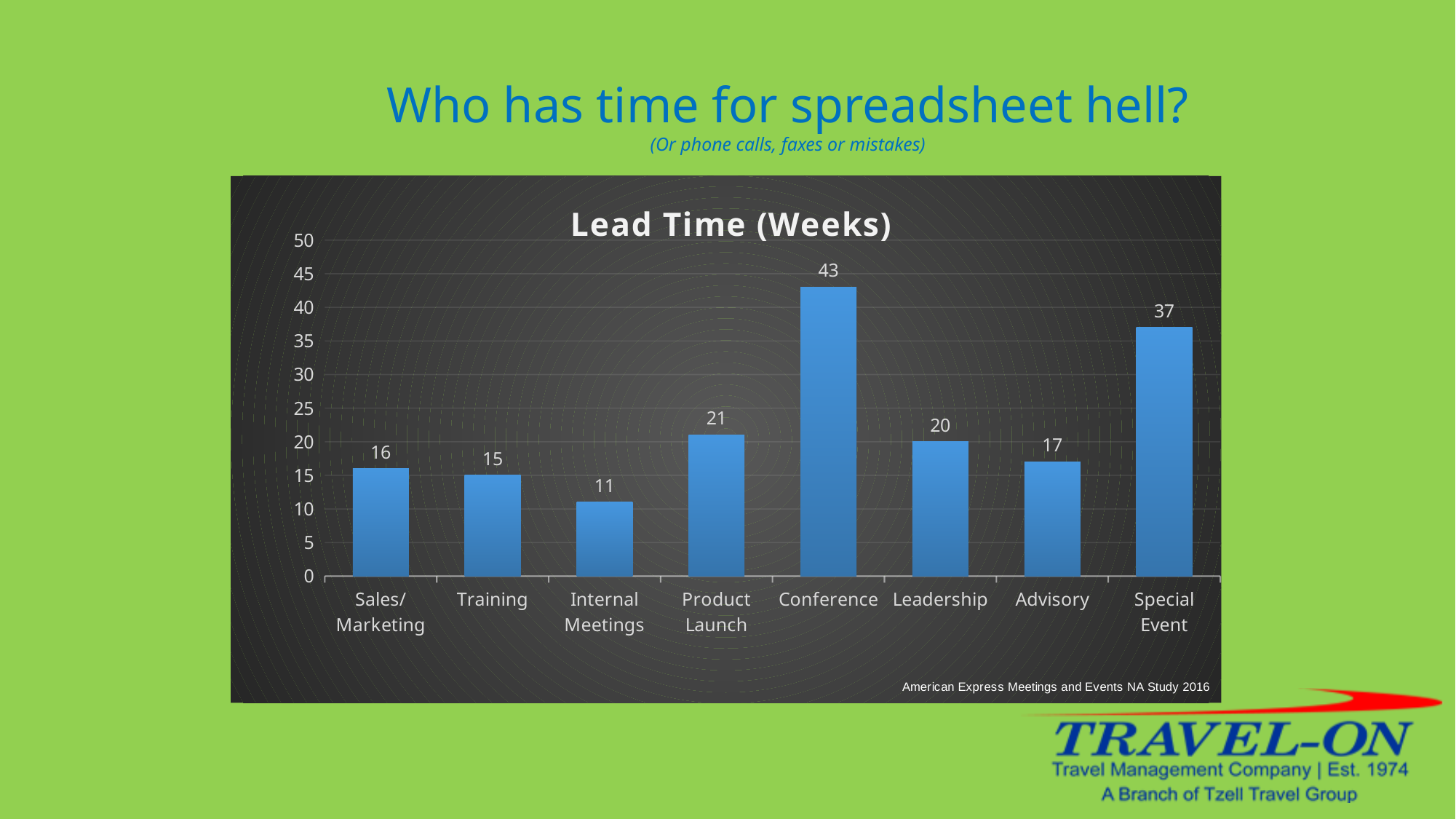
Which has a longer lead time, Leadership or Advisory? Leadership Is the lead time for Special Event greater or less than 35? greater What is the lead time in weeks for Conference? 43 What kind of chart is shown on the slide? Bar chart What is the lead time in weeks for Advisory? 17 Which category has the lowest lead time? Internal Meetings Which category has the highest lead time? Conference How many categories are shown in the chart? 8 What is the title of the chart? Lead Time (Weeks) What is the lead time in weeks for Internal Meetings? 11 What is the difference in lead time between Product Launch and Training? 6 What is the difference in lead time between Conference and Special Event? 6